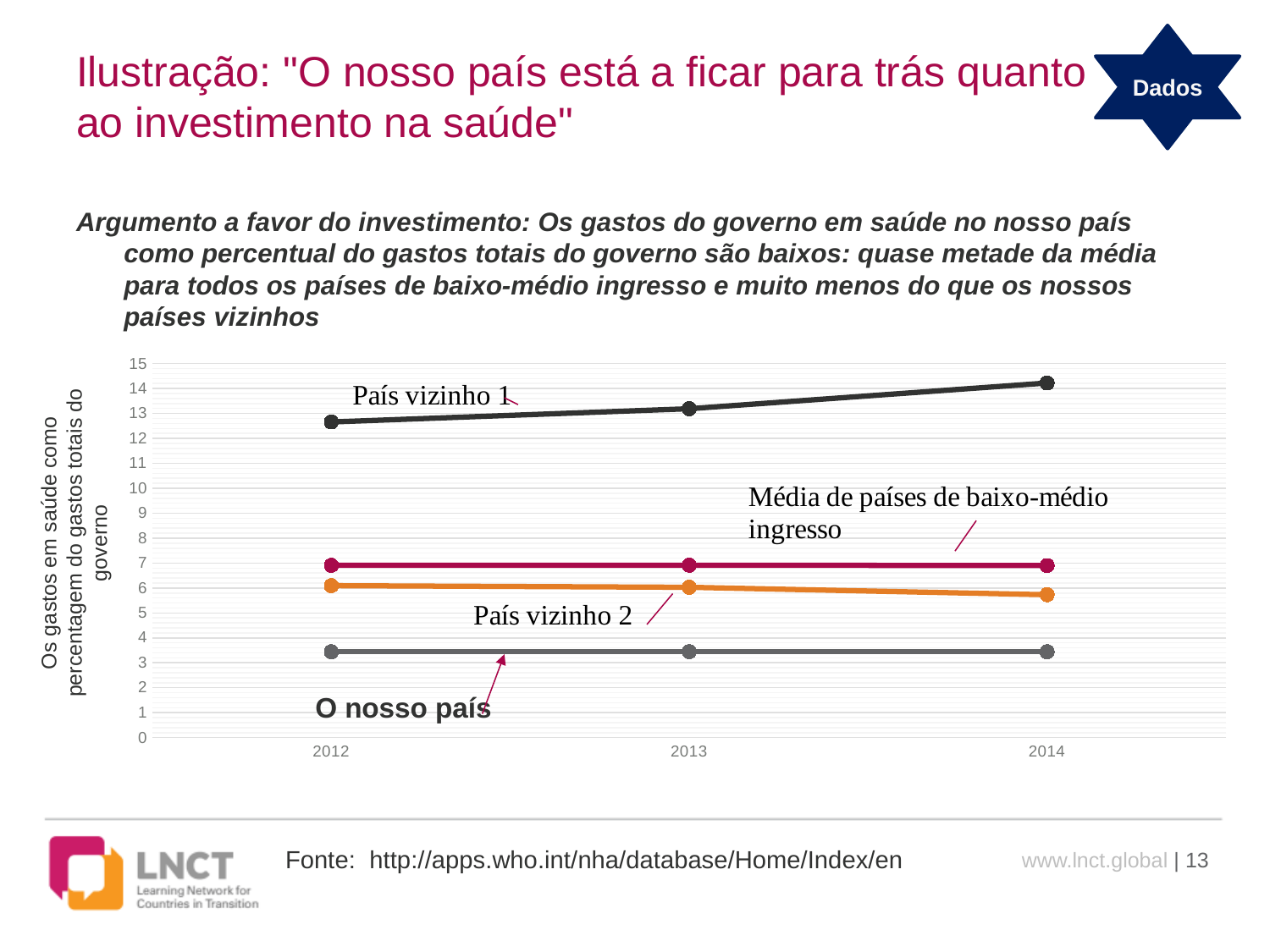
What is the label of the y axis of the chart? Os gastos em saúde como percentagem do gastos totais do governo Which series has the highest value in 2014? País vizinho 1 How many lines (series) are plotted on the chart? 4 What kind of chart is shown on the slide? Line chart Which series has the lowest value in 2013? O nosso país Is the value for País vizinho 1 in 2014 greater or less than 13? greater How many years are shown on the x axis of the chart? 3 Does the value for País vizinho 1 rise or fall from 2012 to 2014? Rise Is the value for O nosso país in 2012 greater or less than 4? less Does the value for País vizinho 2 rise or fall from 2012 to 2014? Fall Is the value for Média de países de baixo-médio ingresso in 2013 greater or less than 8? less In 2014, which is larger: Média de países de baixo-médio ingresso or País vizinho 2? Média de países de baixo-médio ingresso